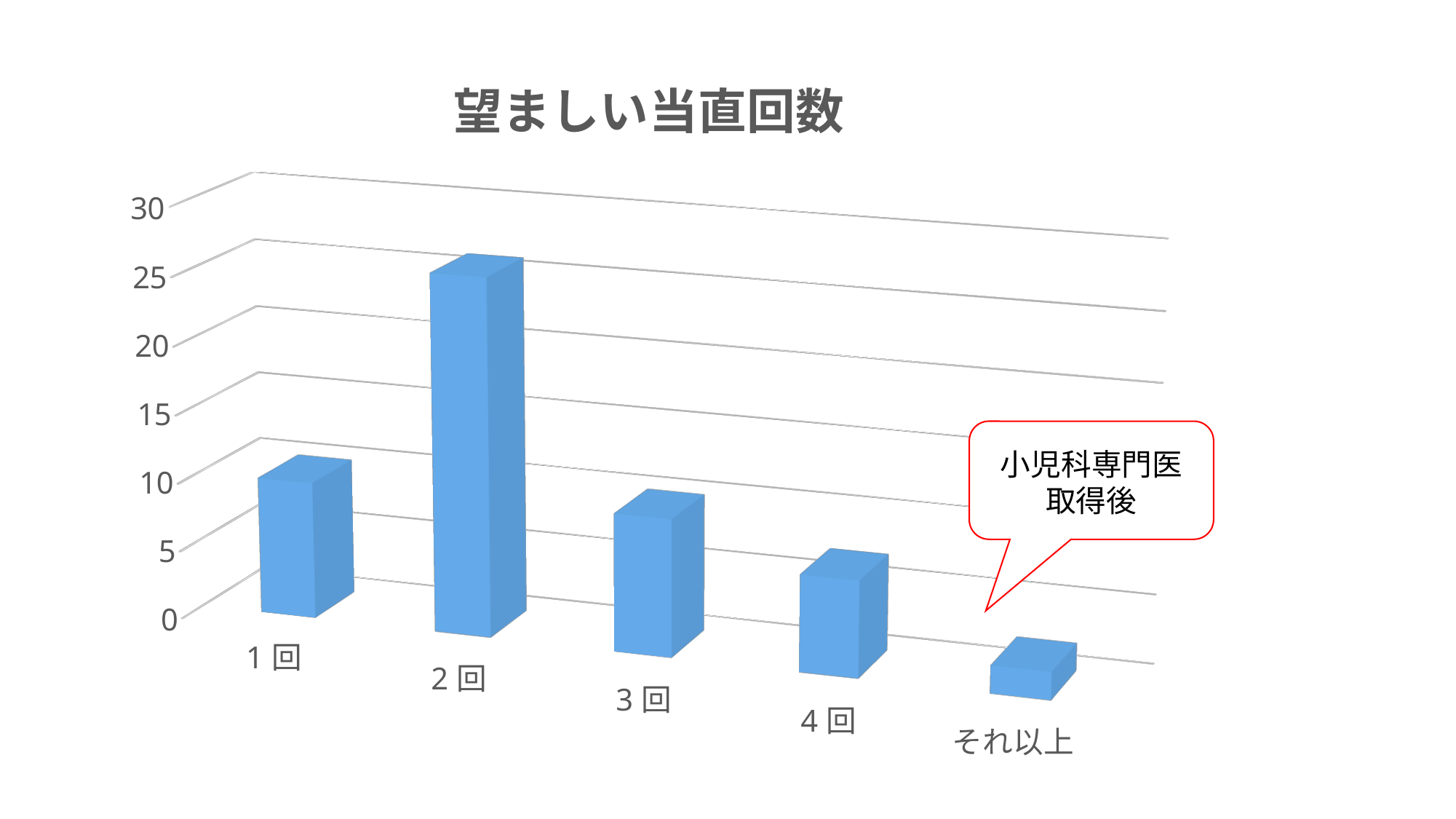
What text is written in the callout pointing at the それ以上 bar? 小児科専門医取得後 Which category has the lowest value? それ以上 Which is larger, the value for 1回 or the value for 4回? 1回 What kind of chart is shown on the slide? bar chart Is the value for 4回 greater or less than 10? less How many categories are shown on the x axis? 5 Is the value for 2回 greater or less than 20? greater Which is larger, the value for 2回 or the value for 3回? 2回 Is the value for 1回 greater or less than 15? less What is the title of the chart? 望ましい当直回数 Which category has the highest value? 2回